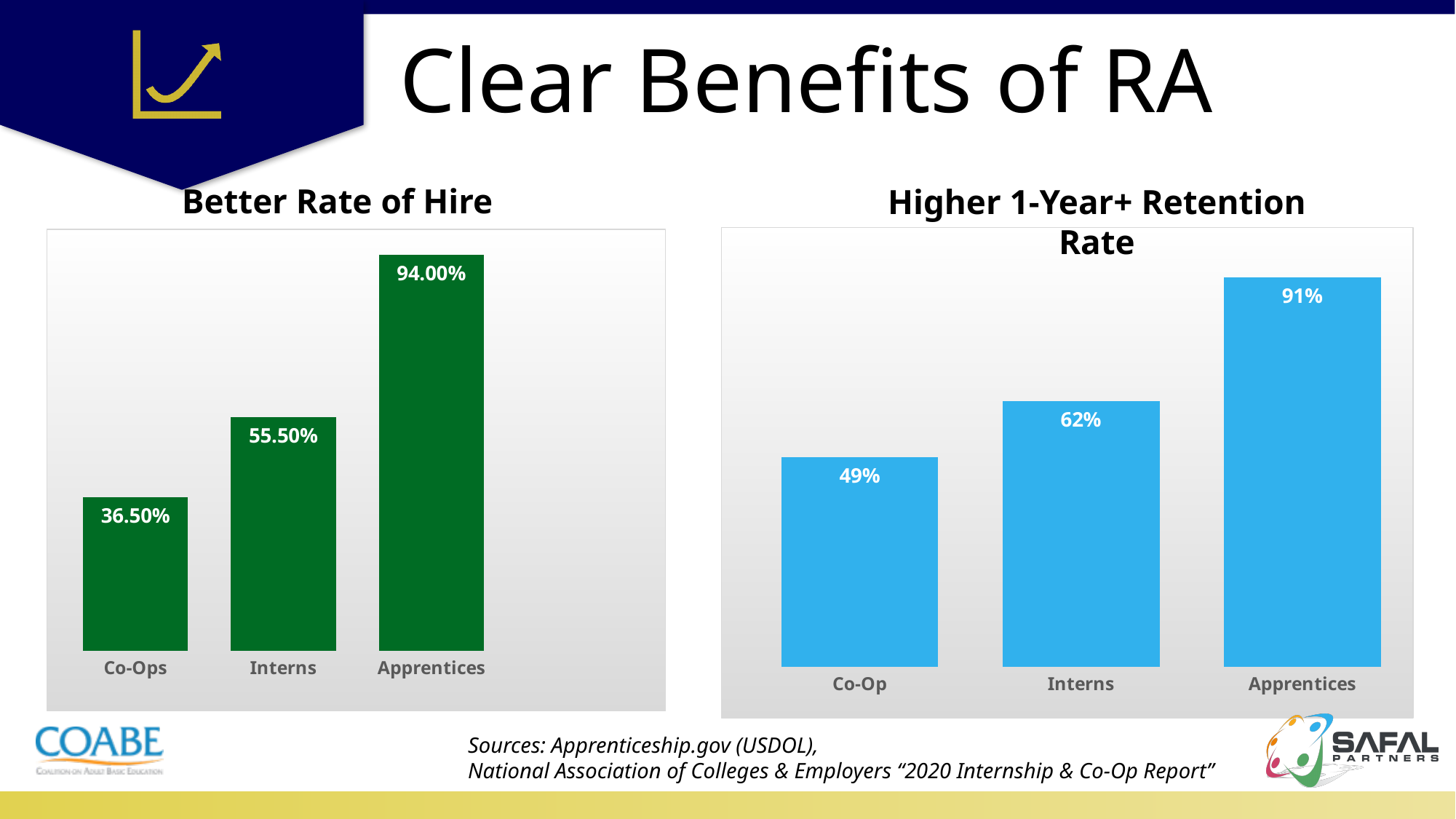
In the 'Higher 1-Year+ Retention Rate' chart, what is the value for Co-Op? 49% In the 'Better Rate of Hire' chart, what is the difference between the values for Apprentices and Interns? 38.50% In the 'Better Rate of Hire' chart, what is the value for Apprentices? 94.00% In the 'Better Rate of Hire' chart, which category has the lowest value? Co-Ops In the 'Better Rate of Hire' chart, what is the value for Co-Ops? 36.50% In the 'Higher 1-Year+ Retention Rate' chart, do the values rise or fall from Co-Op to Apprentices? Rise In the 'Better Rate of Hire' chart, which is larger, the value for Interns or the value for Co-Ops? Interns In the 'Higher 1-Year+ Retention Rate' chart, what is the difference between the values for Apprentices and Co-Op? 42% In the 'Higher 1-Year+ Retention Rate' chart, what is the value for Interns? 62% In the 'Higher 1-Year+ Retention Rate' chart, which category has the highest value? Apprentices What kind of chart is the 'Better Rate of Hire' chart? Bar chart How many categories are shown in the 'Higher 1-Year+ Retention Rate' chart? 3